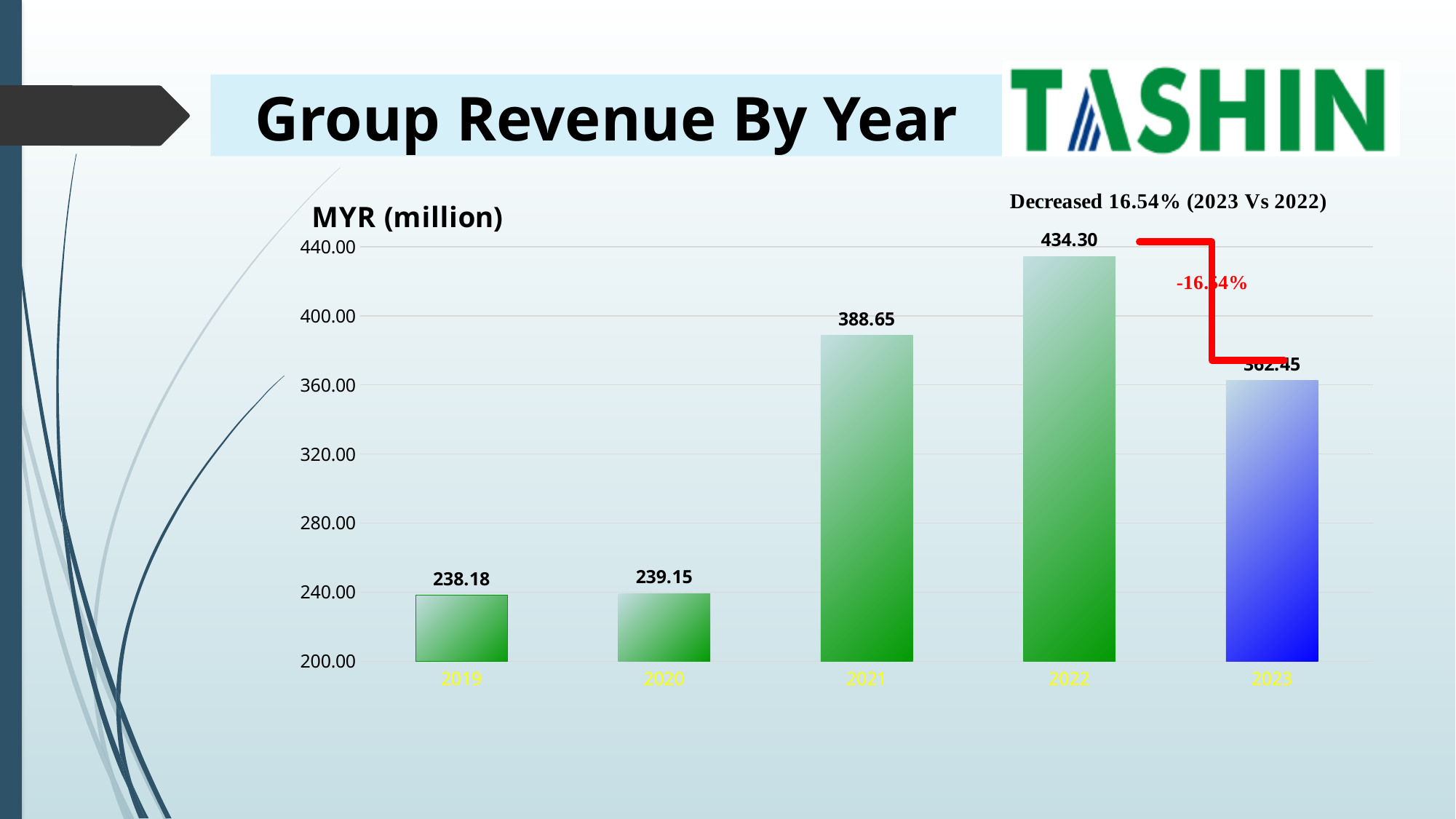
Which year has the lowest group revenue? 2019 What is the group revenue for 2019? 238.18 What unit is shown on the y axis of the chart? MYR (million) How many years are shown on the chart? 5 What kind of chart is shown on the slide? bar chart Which year has the highest group revenue? 2022 Which year has higher group revenue, 2021 or 2023? 2021 Is the group revenue for 2023 greater or less than 400.00? less What is the group revenue for 2020? 239.15 What is the group revenue for 2021? 388.65 What is the difference in group revenue between 2022 and 2021? 45.65 What is the group revenue for 2022? 434.30